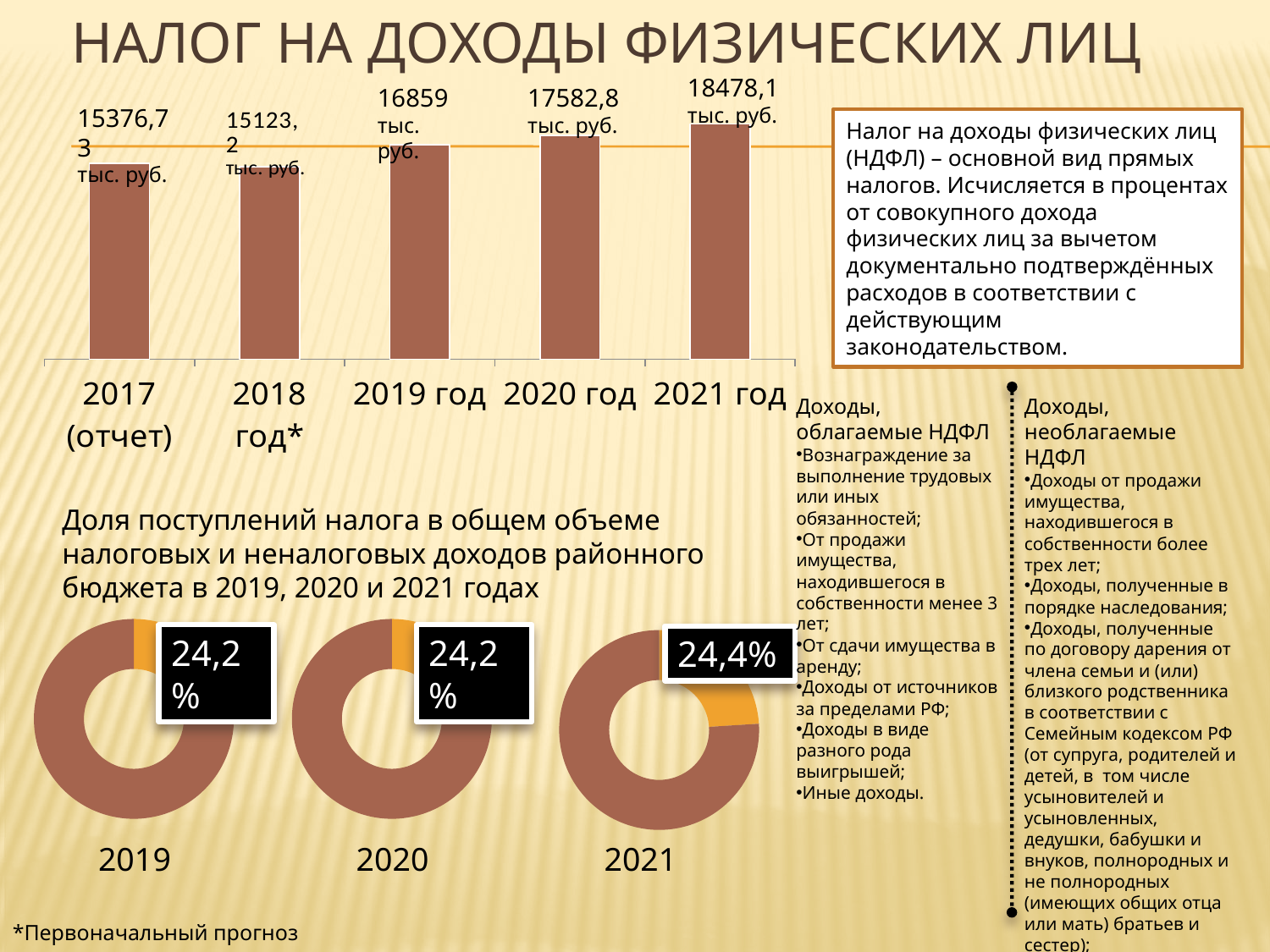
In the donut chart for 2019, what share is shown? 24,2% In the bar chart, what is the value for 2020 год? 17582,8 тыс. руб. In the bar chart, which year has the highest value? 2021 год In the bar chart, what is the value for 2019 год? 16859 тыс. руб. In the bar chart, what is the value for 2021 год? 18478,1 тыс. руб. In the bar chart, which year has the lowest value? 2018 год* In the bar chart, what is the difference between the values for 2021 год and 2020 год? 895,3 тыс. руб. How many bars are in the bar chart at the top of the slide? 5 In the bar chart, what is the value for 2018 год*? 15123,2 тыс. руб. What kind of chart is shown at the top of the slide? bar chart In the bar chart, which is larger: the value for 2019 год or the value for 2018 год*? 2019 год In the donut chart for 2021, what share is shown? 24,4%